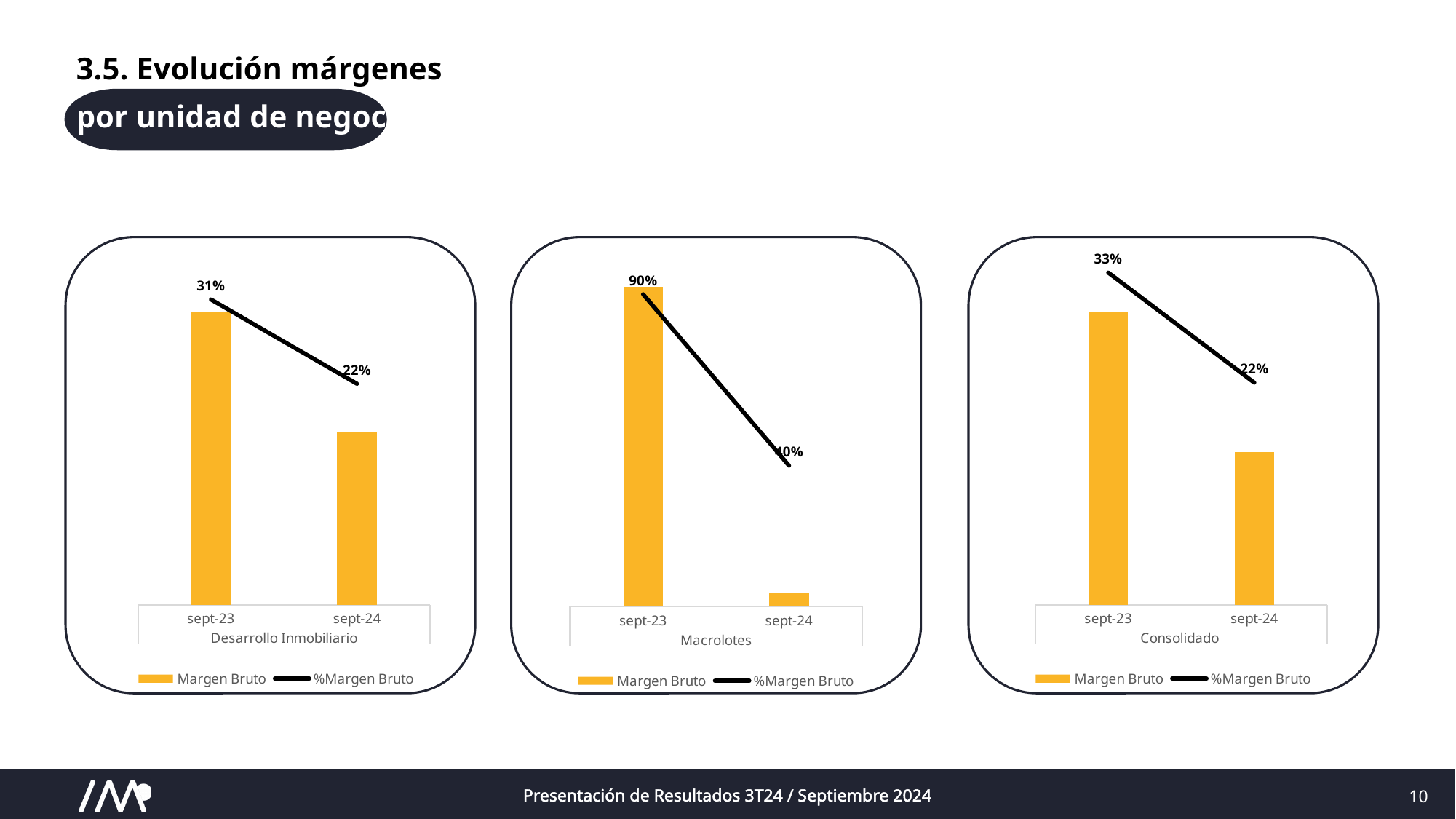
In the Desarrollo Inmobiliario chart, by how many percentage points did the %Margen Bruto fall from sept-23 to sept-24? 9 percentage points In the Macrolotes chart, does the %Margen Bruto rise or fall from sept-23 to sept-24? fall How many periods are shown on the x axis of the Desarrollo Inmobiliario chart? 2 In the Macrolotes chart, which period has the larger Margen Bruto bar, sept-23 or sept-24? sept-23 In the Consolidado chart, what is the %Margen Bruto for sept-24? 22% In the Desarrollo Inmobiliario chart, what is the %Margen Bruto for sept-23? 31% In the Consolidado chart, by how many percentage points did the %Margen Bruto fall from sept-23 to sept-24? 11 percentage points What colour are the Margen Bruto bars in the Macrolotes chart? Yellow/orange In the Macrolotes chart, what is the %Margen Bruto for sept-23? 90% In the Desarrollo Inmobiliario chart, what is the %Margen Bruto for sept-24? 22% In the Consolidado chart, what is the %Margen Bruto for sept-23? 33% How many series does the legend of the Consolidado chart list? 2